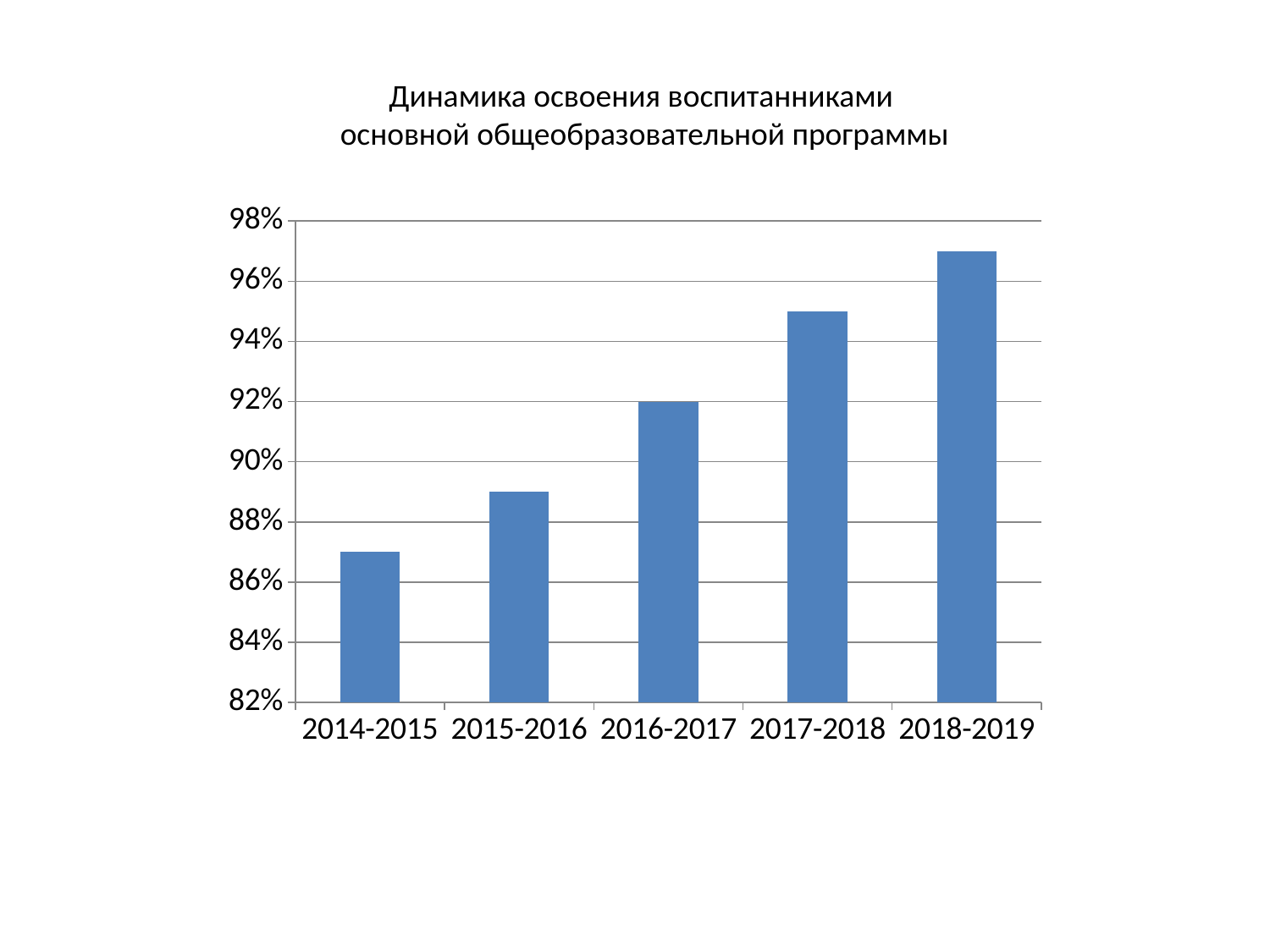
How many academic years are shown on the x axis of the chart? 5 Is the value for 2015-2016 greater or less than 88%? greater What is the value for 2016-2017 in the chart? 92% Do the values rise or fall from 2014-2015 to 2018-2019? rise Is the value for 2018-2019 greater or less than 96%? greater Which academic year has the lowest bar in the chart? 2014-2015 What kind of chart is shown on the slide? bar chart Is the value for 2017-2018 greater or less than 94%? greater Which academic year has the highest bar in the chart? 2018-2019 What is the title of the chart? Динамика освоения воспитанниками основной общеобразовательной программы Which is larger, the value for 2015-2016 or the value for 2017-2018? 2017-2018